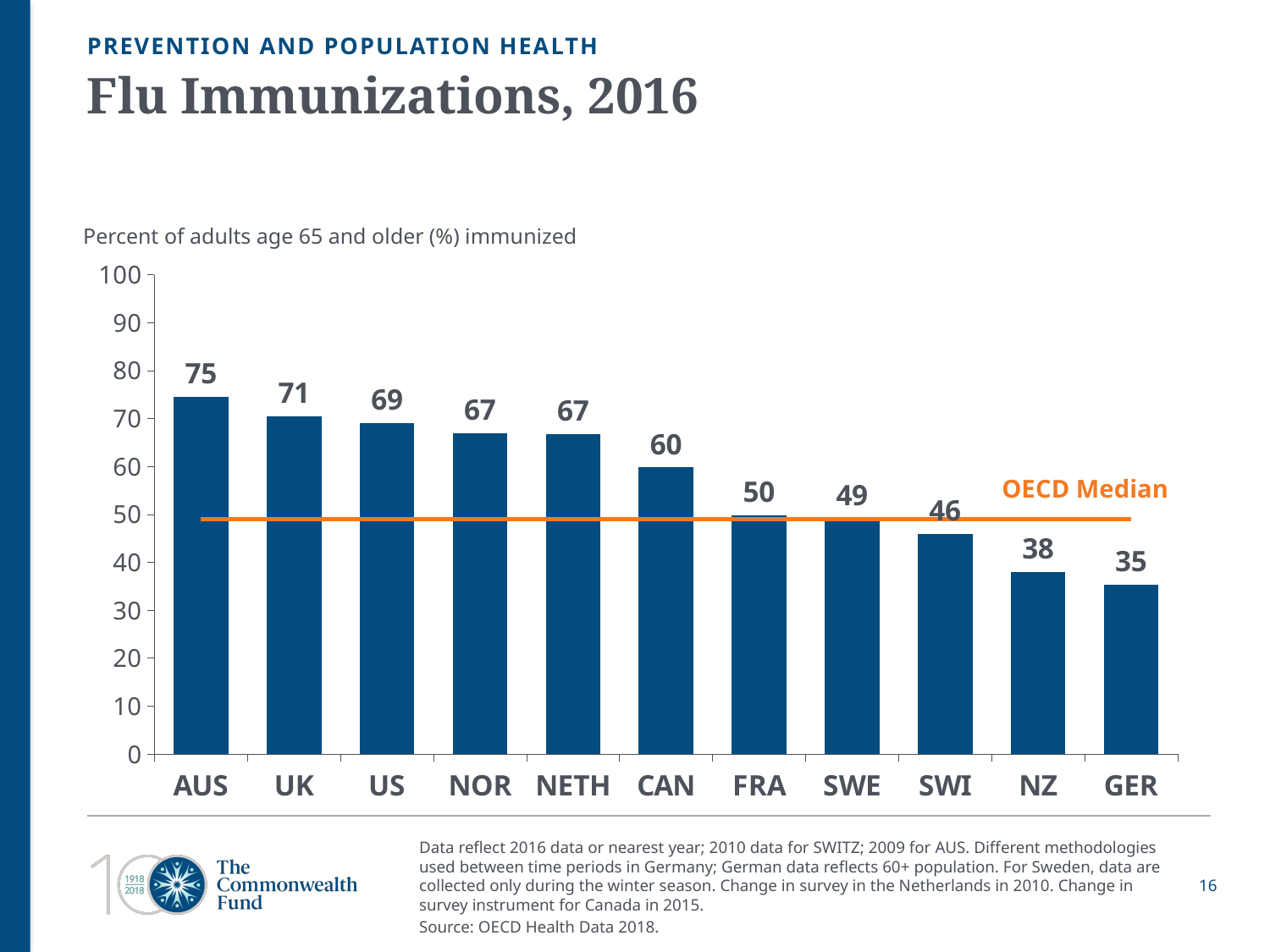
Is the value for US greater or less than 60? greater What is the value shown for NZ? 38 Which country has the lowest flu immunization rate? GER What is the difference between the values for UK and GER? 36 What is the flu immunization rate for AUS? 75 Which has a higher value, FRA or SWI? FRA What kind of chart is shown on the slide? Bar chart How many countries are shown on the chart? 11 Which country has the highest flu immunization rate? AUS What is the value shown for CAN? 60 What does the orange horizontal line on the chart represent? OECD Median Do the values rise or fall from left to right along the x axis? Fall